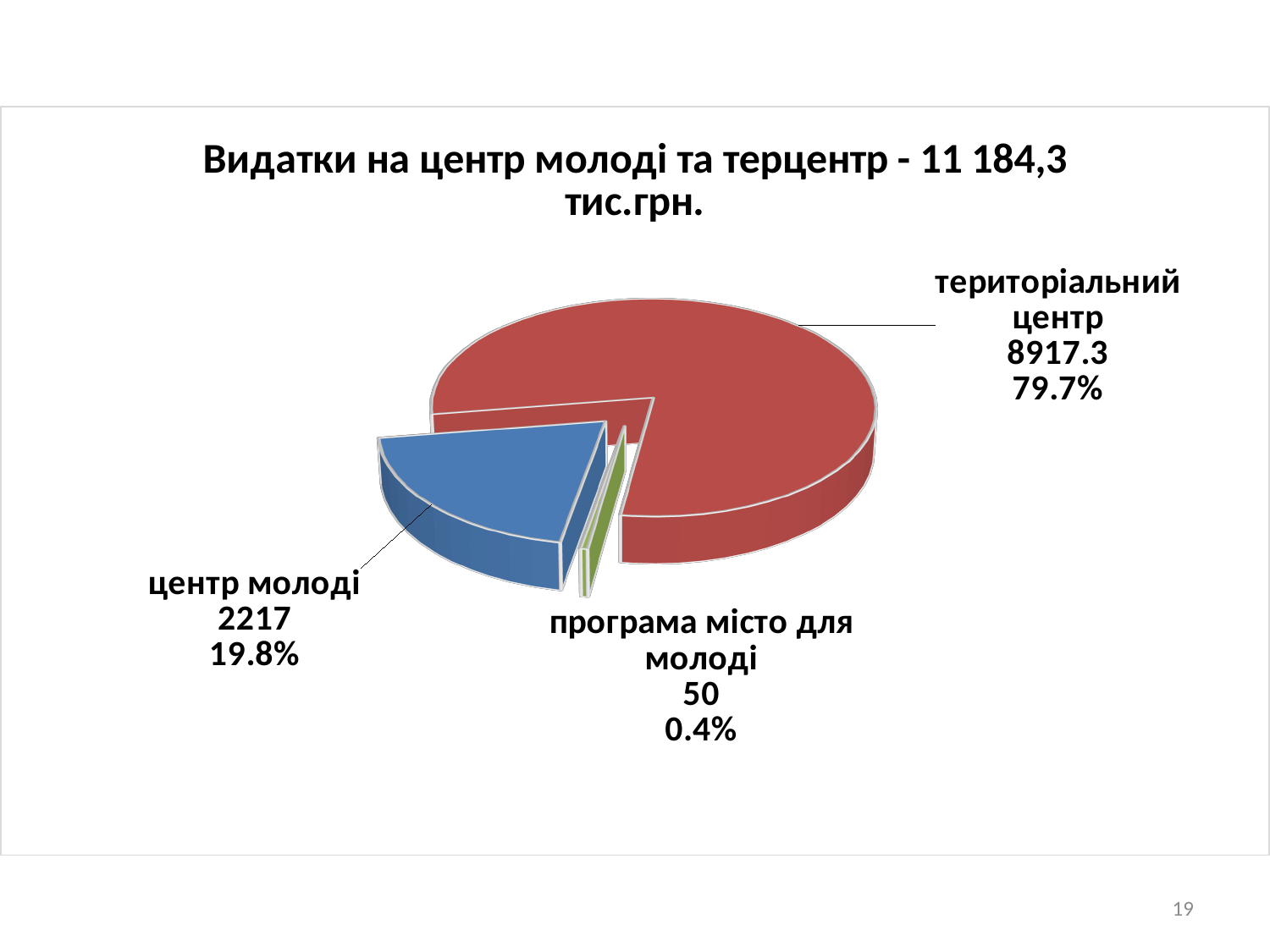
What share of the pie does центр молоді represent? 19.8% What is the value for програма місто для молоді? 50 What share of the pie does програма місто для молоді represent? 0.4% Which category has the smallest slice? програма місто для молоді How many slices does the pie chart have? 3 What kind of chart is shown on the slide? pie chart What is the value for центр молоді? 2217 What share of the pie does територіальний центр represent? 79.7% What is the difference between the values for територіальний центр and центр молоді? 6700.3 Which category has the largest slice? територіальний центр What is the value for територіальний центр? 8917.3 What is the title of the chart? Видатки на центр молоді та терцентр - 11 184,3 тис.грн.